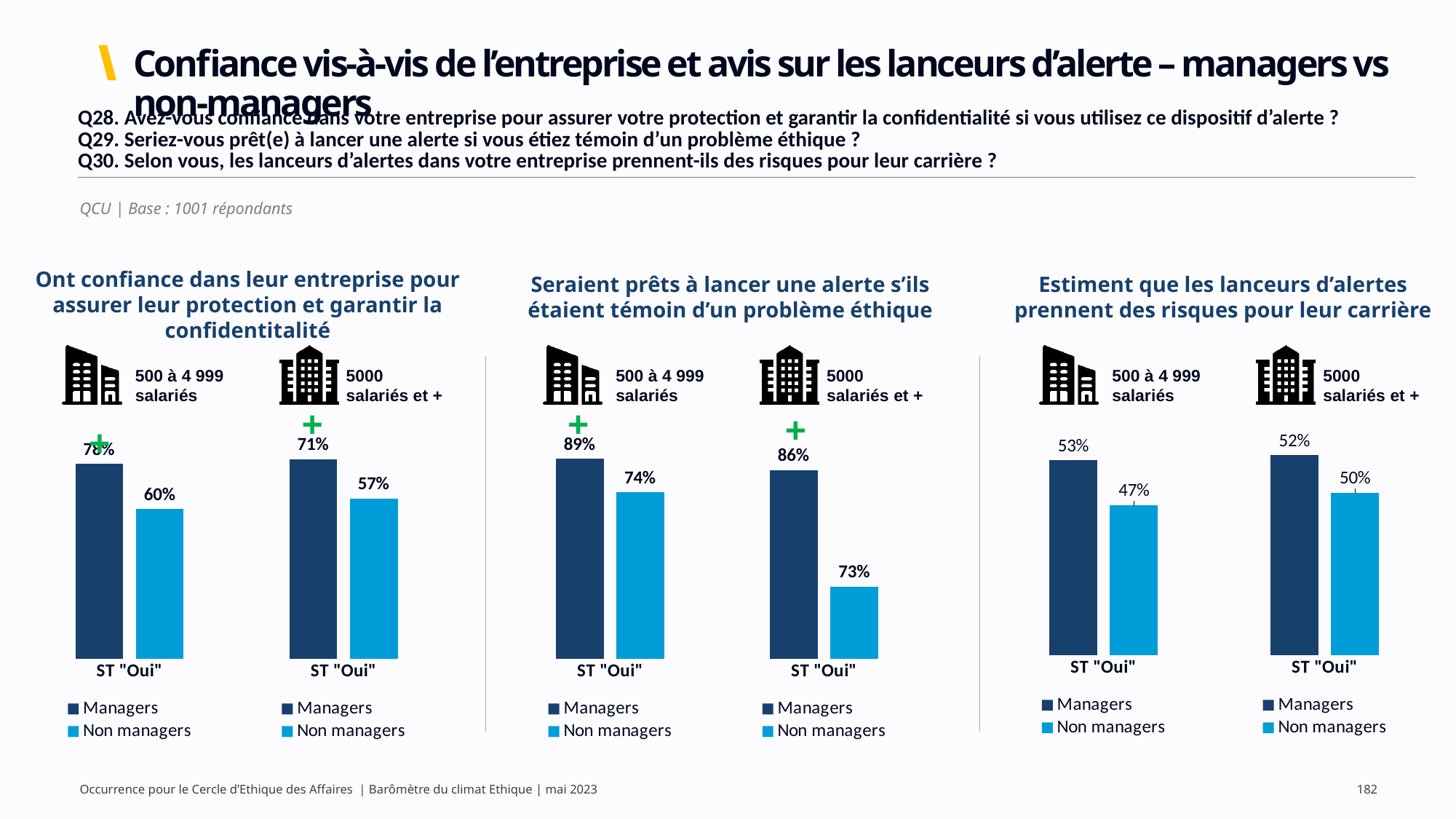
How many series does the legend list in each chart on the slide? 2 In the chart 'Ont confiance dans leur entreprise pour assurer leur protection et garantir la confidentitalité' for 500 à 4 999 salariés, what is the value for Non managers? 60% In the chart 'Seraient prêts à lancer une alerte...' for 500 à 4 999 salariés, what is the difference between Managers and Non managers? 15 percentage points In the chart 'Ont confiance dans leur entreprise...' for 5000 salariés et +, what is the difference between Managers and Non managers? 14 percentage points In the chart 'Seraient prêts à lancer une alerte s'ils étaient témoin d'un problème éthique' for 500 à 4 999 salariés, what is the value for Managers? 89% In the chart 'Estiment que les lanceurs d'alertes...' for 5000 salariés et +, what is the difference between Managers and Non managers? 2 percentage points In the chart 'Seraient prêts à lancer une alerte...' for 5000 salariés et +, which is larger, Managers or Non managers? Managers In the chart 'Seraient prêts à lancer une alerte...' for 5000 salariés et +, what is the value for Non managers? 73% What kind of chart is used in the 'Estiment que les lanceurs d'alertes prennent des risques pour leur carrière' section? Bar chart In the chart 'Estiment que les lanceurs d'alertes prennent des risques pour leur carrière' for 5000 salariés et +, what is the value for Managers? 52% In the chart 'Ont confiance dans leur entreprise...' for 5000 salariés et +, what is the value for Managers? 71% In the chart 'Estiment que les lanceurs d'alertes prennent des risques pour leur carrière' for 500 à 4 999 salariés, what is the value for Non managers? 47%